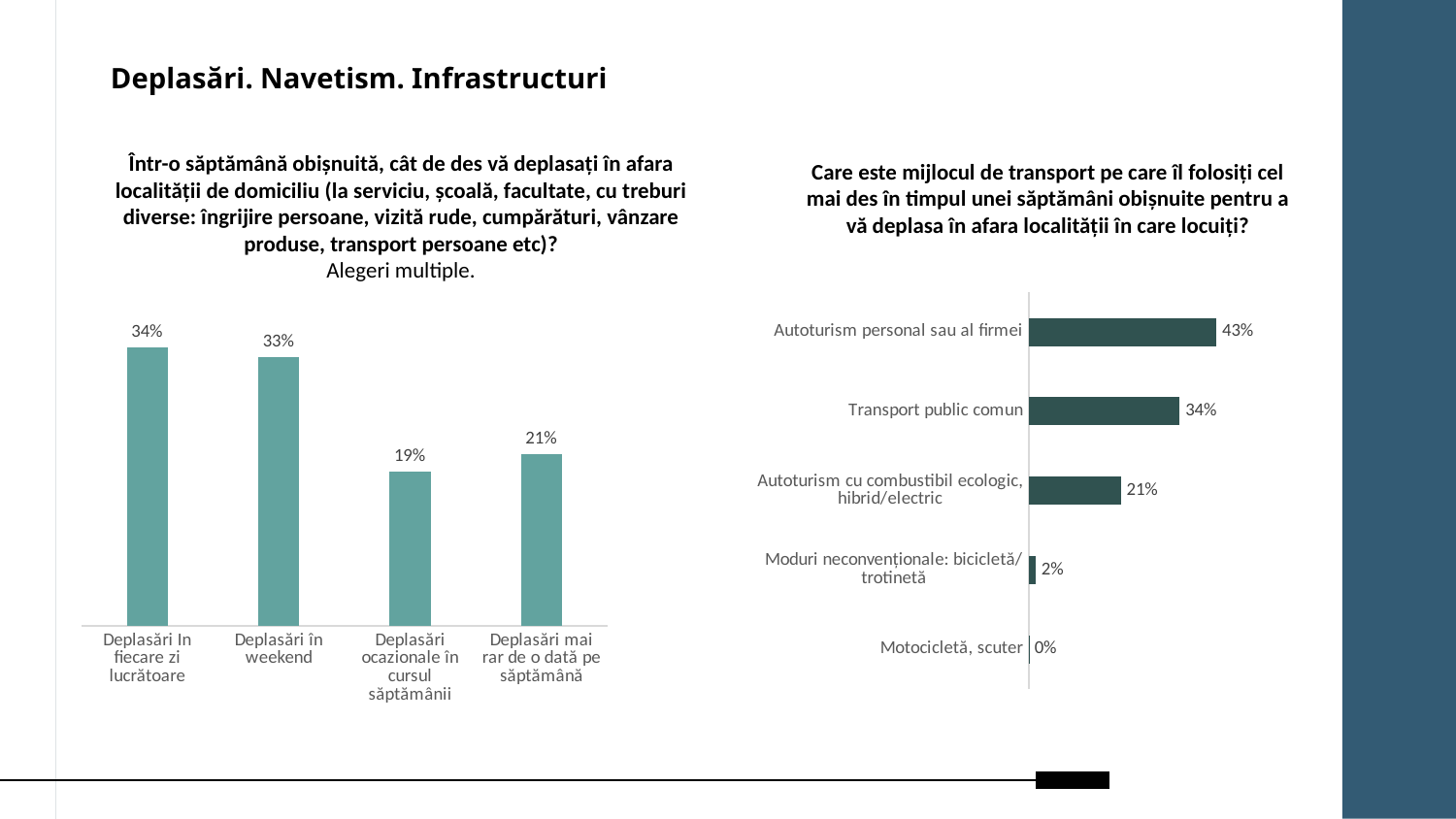
In the right chart, what is the value for 'Transport public comun'? 34% In the left chart, what is the difference between 'Deplasări In fiecare zi lucrătoare' and 'Deplasări mai rar de o dată pe săptămână'? 13% In the left chart, what is the value for 'Deplasări ocazionale în cursul săptămânii'? 19% In the left chart, what is the value for 'Deplasări în weekend'? 33% In the right chart, which category has the lowest value? Motocicletă, scuter In the left chart, which category has the lowest value? Deplasări ocazionale în cursul săptămânii In the right chart, what is the difference between 'Autoturism personal sau al firmei' and 'Autoturism cu combustibil ecologic, hibrid/electric'? 22% What type of chart is the right chart? Bar chart In the right chart, which category has the highest value? Autoturism personal sau al firmei In the left chart, which category has the highest value? Deplasări In fiecare zi lucrătoare In the right chart, what is the value for 'Moduri neconvenționale: bicicletă/trotinetă'? 2% How many categories are shown in the left chart? 4